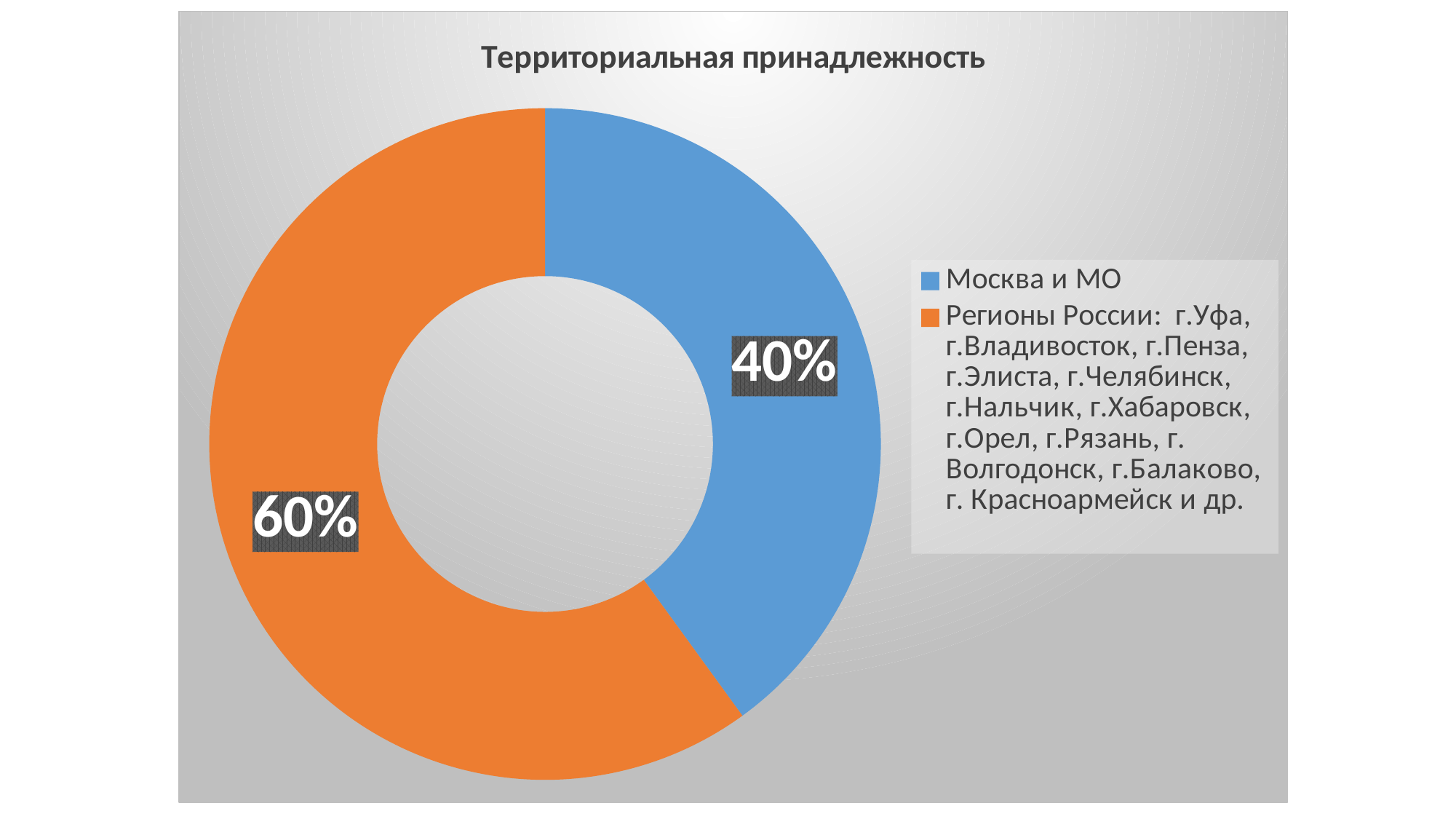
Which category has the largest share? Регионы России How many entries does the legend list? 2 What is the difference in percentage points between Регионы России and Москва и МО? 20% Which category has the smallest share? Москва и МО How many categories does the chart show? 2 What percentage is shown for Регионы России? 60% Which is larger: the share for Москва и МО or the share for Регионы России? Регионы России What colour represents Москва и МО in the chart? Blue What percentage is shown for Москва и МО? 40% What type of chart is shown on the slide? Doughnut (pie) chart What is the total of the two slices shown? 100% What is the title of the chart? Территориальная принадлежность